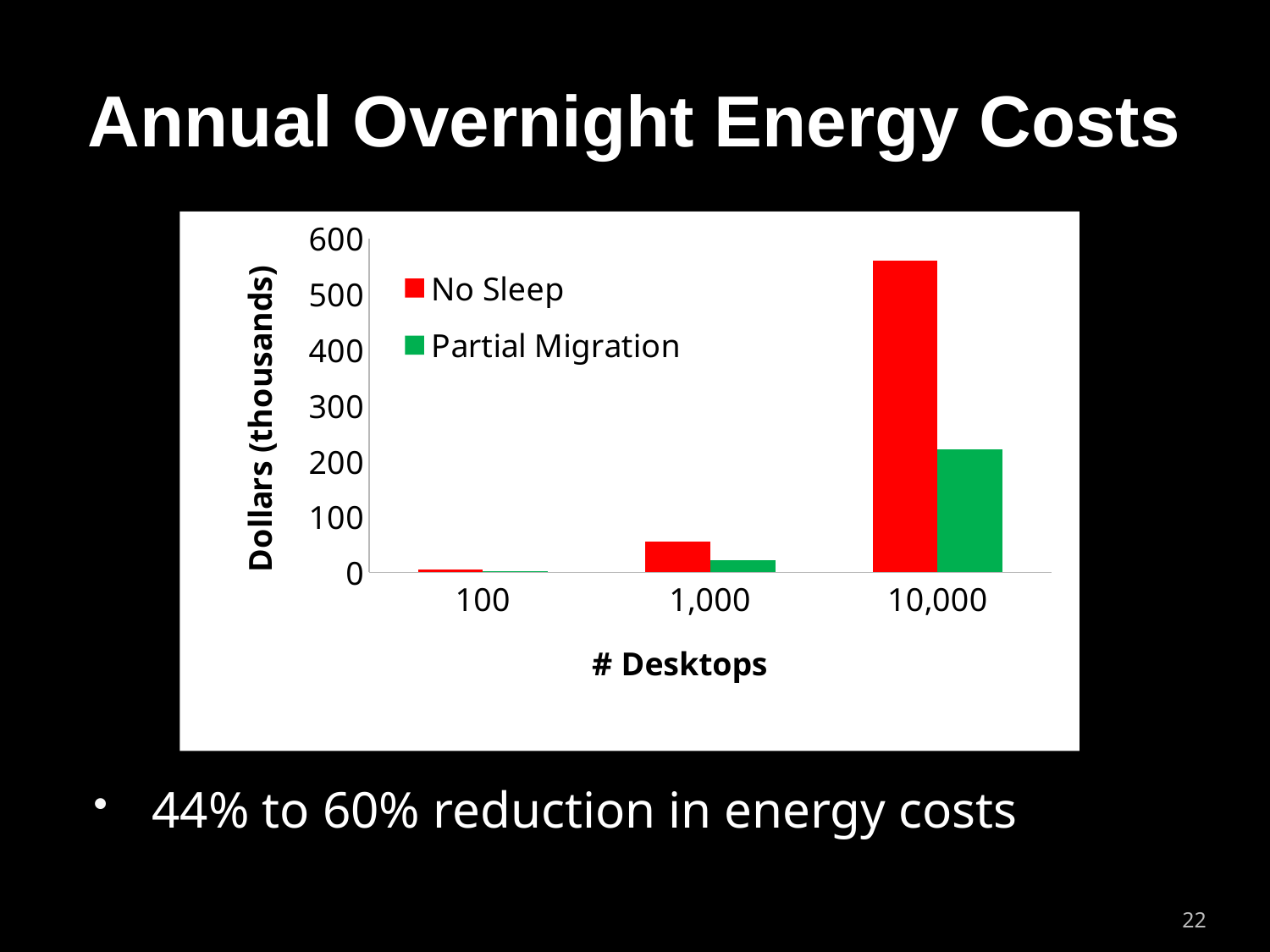
Do the No Sleep values rise or fall as the number of desktops increases along the x axis? rise What kind of chart is shown on the slide? bar chart How many categories are shown on the x axis? 3 How many series does the legend list? 2 Is the No Sleep value for 1,000 desktops greater or less than 100? less Is the No Sleep value for 10,000 desktops greater or less than 500? greater Which # Desktops category has the lowest Partial Migration cost? 100 At 10,000 desktops, which series has the larger value, No Sleep or Partial Migration? No Sleep Which # Desktops category has the highest No Sleep cost? 10,000 Which colour represents the Partial Migration series? green Is the Partial Migration value for 10,000 desktops greater or less than 300? less What is the label of the y axis? Dollars (thousands)